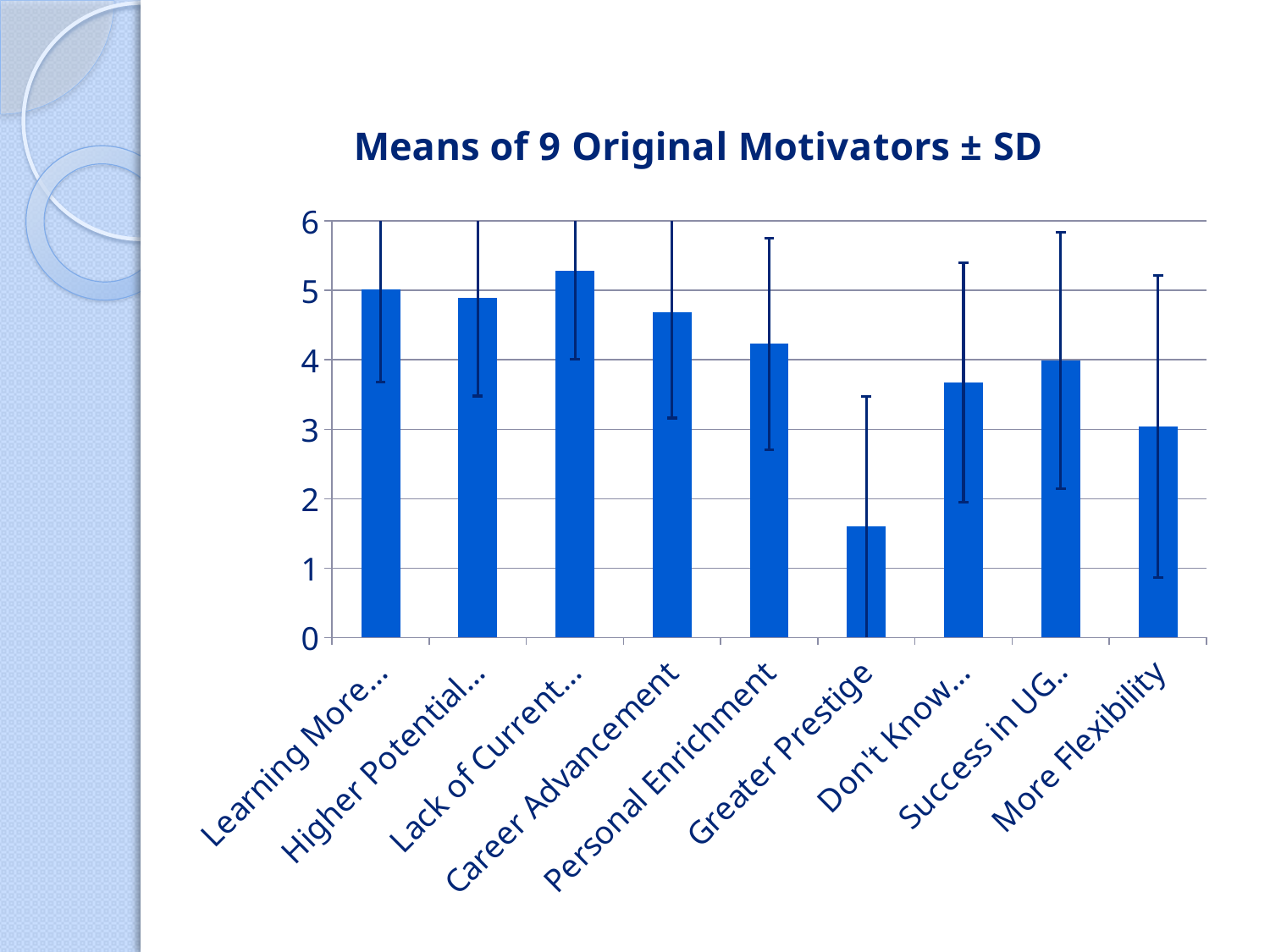
Which category has the highest mean value? Lack of Current... Is the value for More Flexibility greater or less than 4? less Is the value for Greater Prestige greater or less than 2? less How many categories (bars) are plotted in the chart? 9 Which is larger, the value for Personal Enrichment or the value for More Flexibility? Personal Enrichment Which category has the lowest mean value? Greater Prestige What is the maximum value shown on the vertical axis? 6 What kind of chart is shown on the slide? bar chart Is the value for Career Advancement greater or less than 4? greater What is the title of the chart? Means of 9 Original Motivators ± SD Which is larger, the value for Career Advancement or the value for Greater Prestige? Career Advancement